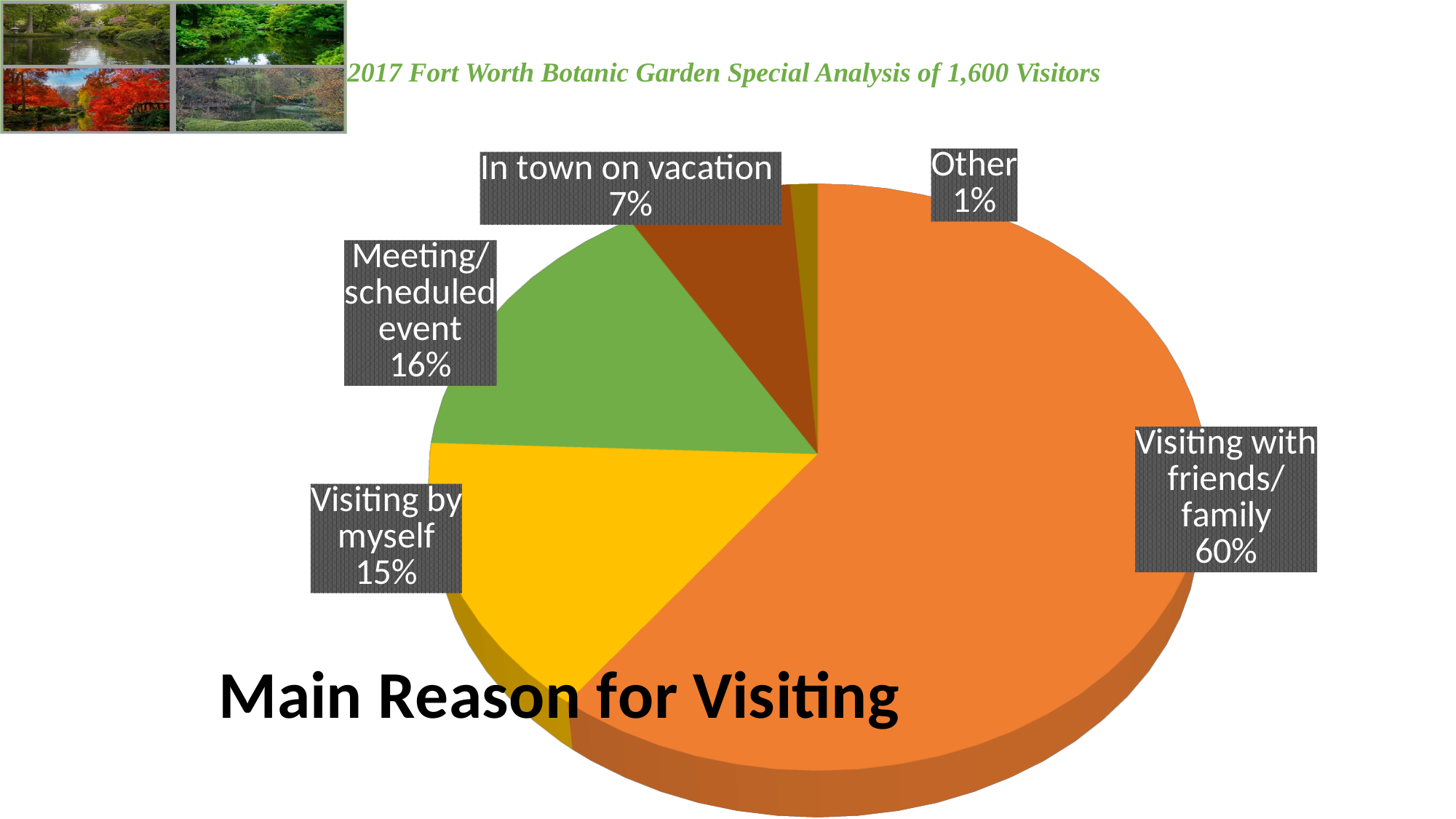
What is the title of the chart? Main Reason for Visiting Which main reason for visiting has the smallest share of the pie? Other What is the difference in percentage points between 'Visiting with friends/family' and 'Meeting/scheduled event'? 44 Which is larger: the share for 'Meeting/scheduled event' or the share for 'Visiting by myself'? Meeting/scheduled event How many reasons for visiting are shown as slices in the pie chart? 5 What colour is the 'Visiting by myself' slice? Yellow Which main reason for visiting has the largest share of the pie? Visiting with friends/family What percentage of visitors said they were 'Visiting by myself'? 15% What kind of chart is used to show the main reason for visiting? Pie chart What share of visitors gave 'Visiting with friends/family' as their main reason for visiting? 60% What share of visitors came for a 'Meeting/scheduled event'? 16% What percentage of visitors were 'In town on vacation'? 7%